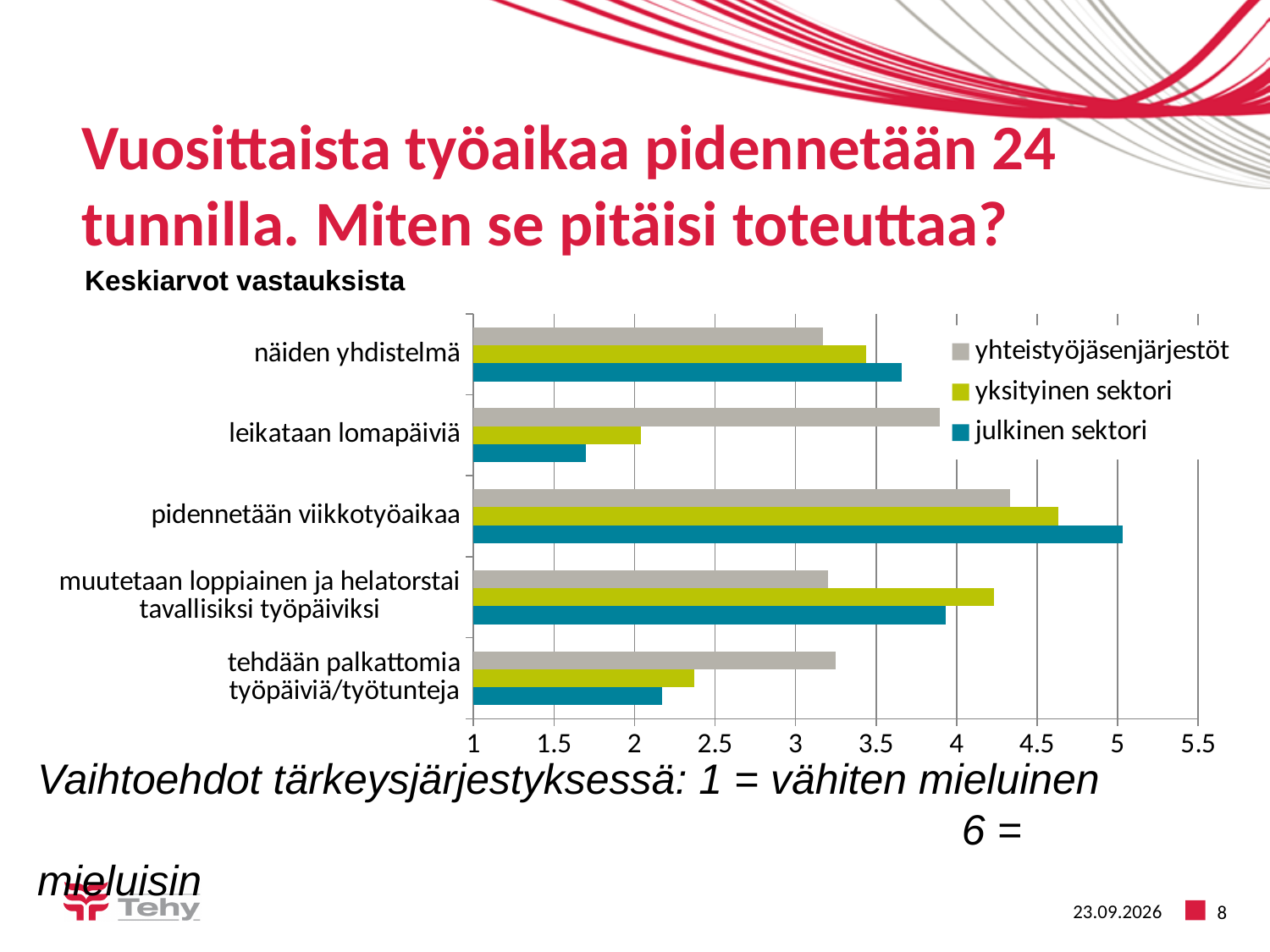
For the series julkinen sektori, which category has the lowest value? leikataan lomapäiviä How many categories are shown on the chart? 5 For the series yksityinen sektori, which category has the highest value? pidennetään viikkotyöaikaa Which colour represents the series julkinen sektori in the legend? blue For the category leikataan lomapäiviä, which series has the larger value: yhteistyöjäsenjärjestöt or yksityinen sektori? yhteistyöjäsenjärjestöt For the category tehdään palkattomia työpäiviä/työtunteja, which series has the larger value: yksityinen sektori or julkinen sektori? yksityinen sektori Is the value for julkinen sektori in the category leikataan lomapäiviä greater or less than 2? less For the series yhteistyöjäsenjärjestöt, which category has the lowest value? näiden yhdistelmä What kind of chart is shown on the slide? bar chart For the series julkinen sektori, which category has the highest value? pidennetään viikkotyöaikaa How many series does the legend list? 3